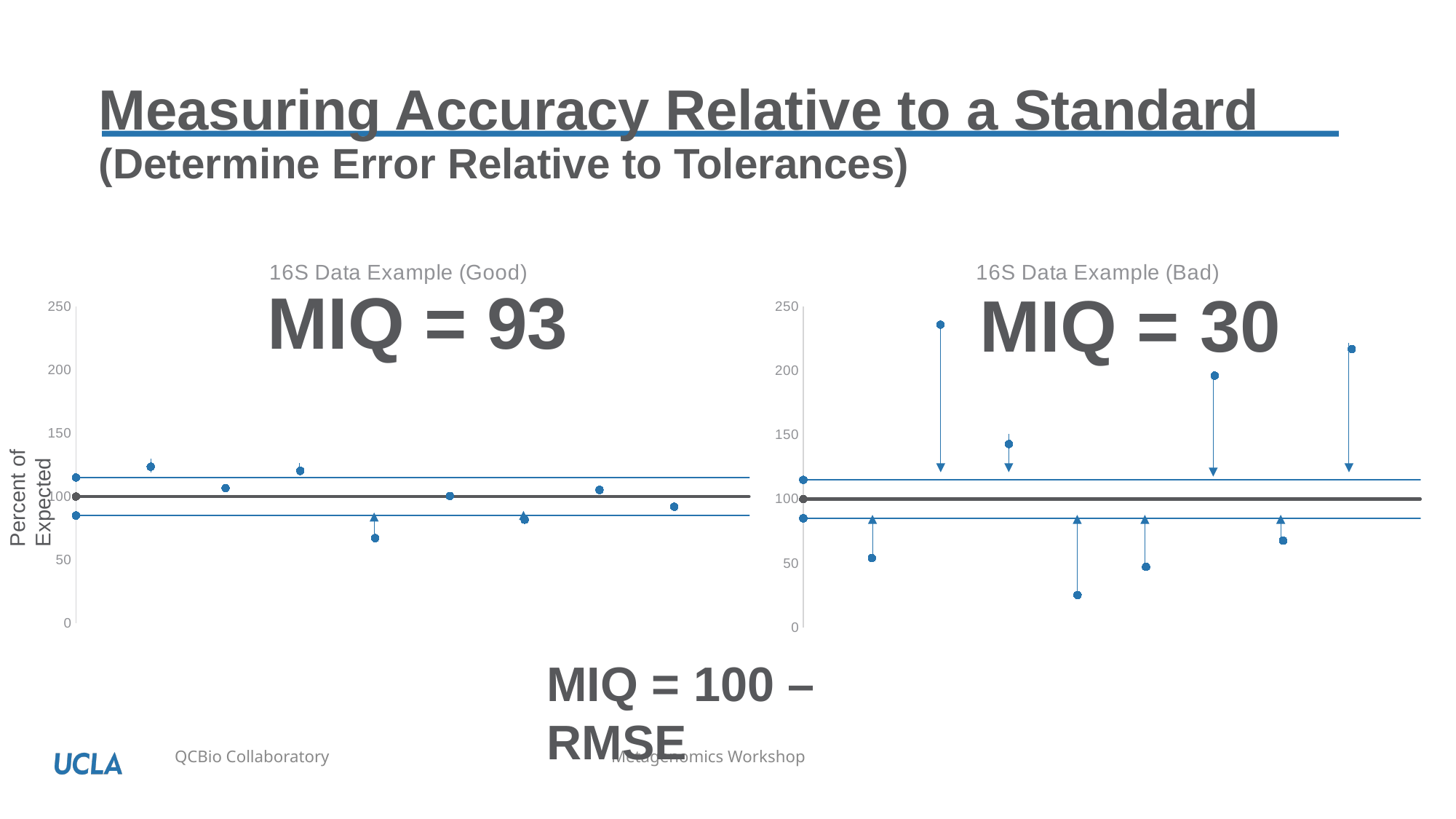
In the '16S Data Example (Good)' chart, how many points are marked with arrows as falling outside the tolerance band? 4 In the '16S Data Example (Good)' chart, is the lowest point greater or less than 50? greater In the '16S Data Example (Bad)' chart, is the highest point greater or less than 200? greater What is the highest value shown on the y-axis of the '16S Data Example (Bad)' chart? 250 What MIQ value is printed on the '16S Data Example (Good)' chart? MIQ = 93 Which chart has the higher maximum plotted value, '16S Data Example (Good)' or '16S Data Example (Bad)'? 16S Data Example (Bad) How many data points are plotted in the '16S Data Example (Good)' chart? 8 What is the y-axis label shared by the two charts? Percent of Expected What kind of chart is the '16S Data Example (Good)' chart? scatter chart How many data points are plotted in the '16S Data Example (Bad)' chart? 8 In the '16S Data Example (Bad)' chart, is the lowest point greater or less than 50? less